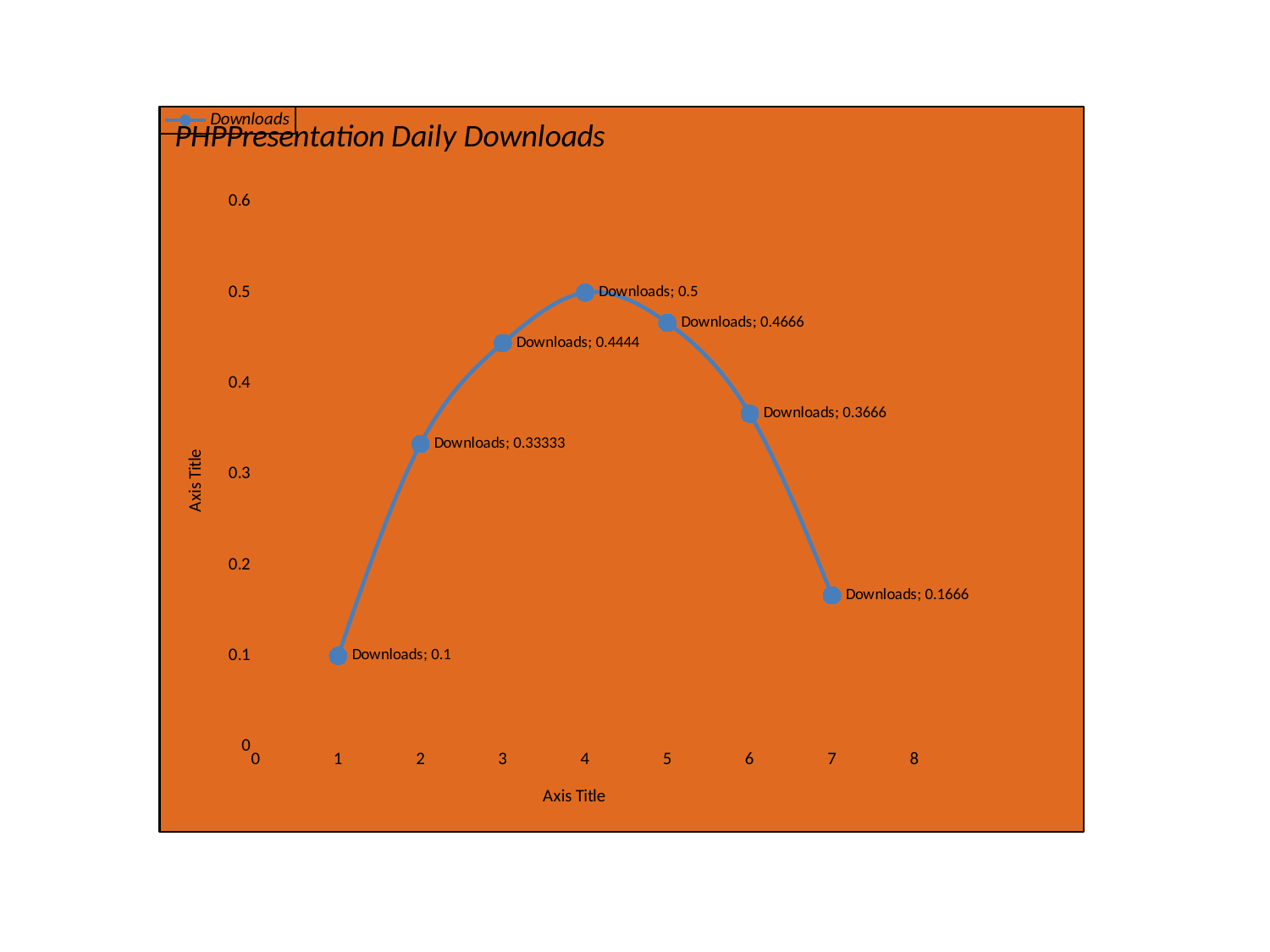
At which x value is the Downloads value lowest? 1 What is the Downloads value at x = 4? 0.5 Which is larger, the Downloads value at x = 3 or at x = 6? x = 3 What is the Downloads value at x = 1? 0.1 How many series does the legend list? 1 What is the difference between the Downloads values at x = 4 and x = 1? 0.4 How many data points are plotted on the chart? 7 What is the Downloads value at x = 2? 0.33333 What is the difference between the Downloads values at x = 5 and x = 6? 0.1 At which x value is the Downloads value highest? 4 What is the Downloads value at x = 7? 0.1666 What is the title of the chart? PHPPresentation Daily Downloads